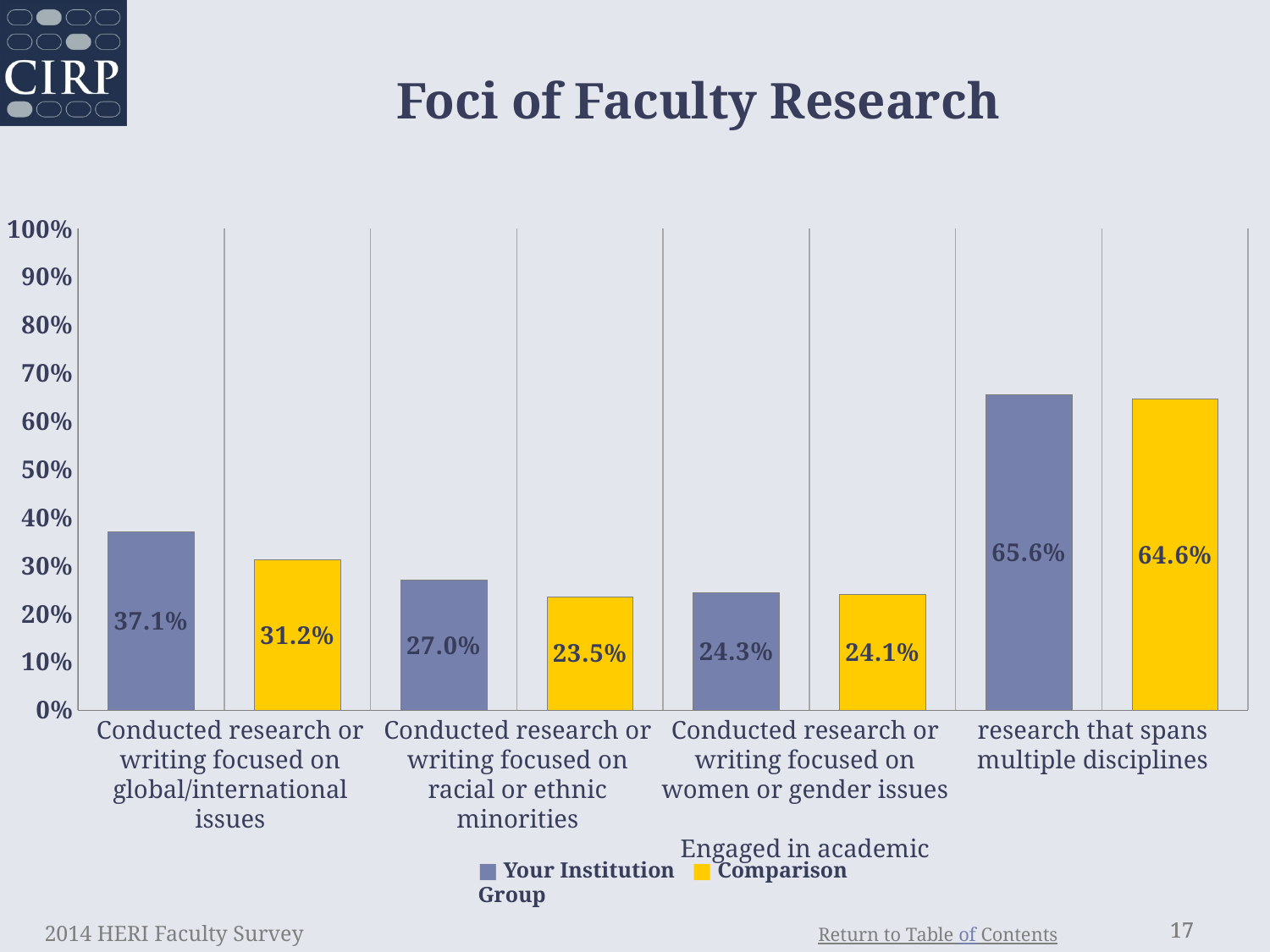
Which category has the lowest Comparison Group value? Conducted research or writing focused on racial or ethnic minorities What type of chart is shown on the slide? Bar chart What is the value for Your Institution for 'Conducted research or writing focused on global/international issues'? 37.1% What is the Comparison Group value for 'Conducted research or writing focused on women or gender issues'? 24.1% What is the Your Institution value for 'Engaged in academic research that spans multiple disciplines'? 65.6% Is the Comparison Group value for 'Engaged in academic research that spans multiple disciplines' greater or less than 60%? greater What is the Comparison Group value for 'Conducted research or writing focused on racial or ethnic minorities'? 23.5% How many categories are shown on the x axis? 4 For 'Conducted research or writing focused on racial or ethnic minorities', which is larger: Your Institution or Comparison Group? Your Institution What is the difference between the Your Institution and Comparison Group values for 'Conducted research or writing focused on global/international issues'? 5.9% How many series does the legend list? 2 Which category has the highest Your Institution value? Engaged in academic research that spans multiple disciplines